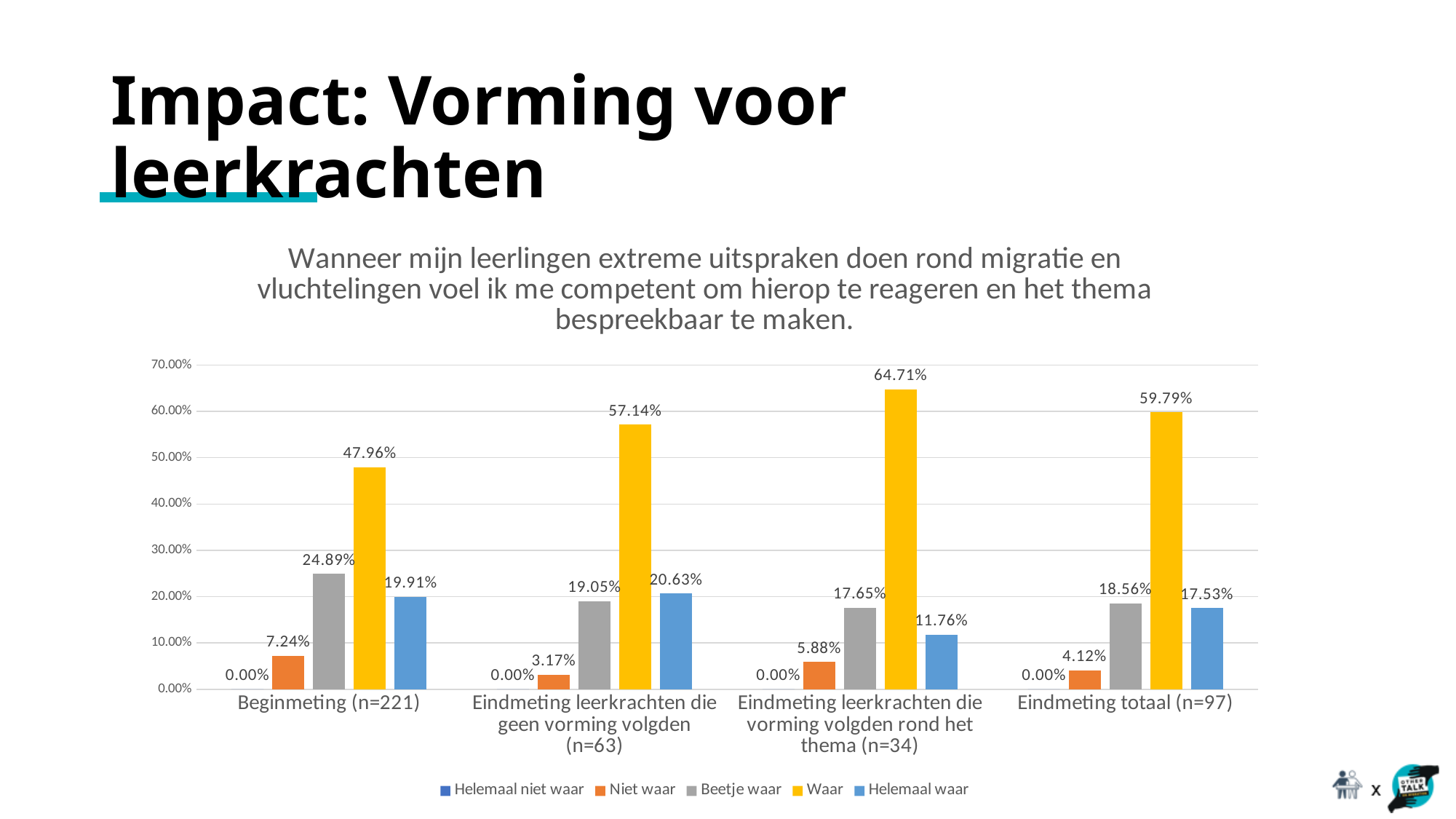
What is the value for 'Helemaal waar' in the 'Eindmeting leerkrachten die vorming volgden rond het thema (n=34)' category? 11.76% What is the value for 'Waar' in the 'Beginmeting (n=221)' category? 47.96% Does the 'Waar' value rise or fall from 'Beginmeting (n=221)' to 'Eindmeting leerkrachten die vorming volgden rond het thema (n=34)' along the x axis? rise How many categories are shown on the x axis? 4 How many series does the legend list? 5 What is the difference between the 'Waar' values for 'Eindmeting leerkrachten die vorming volgden rond het thema (n=34)' and 'Beginmeting (n=221)'? 16.75% What is the value for 'Niet waar' in the 'Eindmeting totaal (n=97)' category? 4.12% Which is larger: 'Helemaal waar' for 'Beginmeting (n=221)' or 'Helemaal waar' for 'Eindmeting leerkrachten die geen vorming volgden (n=63)'? Eindmeting leerkrachten die geen vorming volgden (n=63) In which category is the 'Waar' value highest? Eindmeting leerkrachten die vorming volgden rond het thema (n=34) In which category is the 'Beetje waar' value lowest? Eindmeting leerkrachten die vorming volgden rond het thema (n=34) What kind of chart is shown on the slide? bar chart Which series is shown in yellow in the legend? Waar